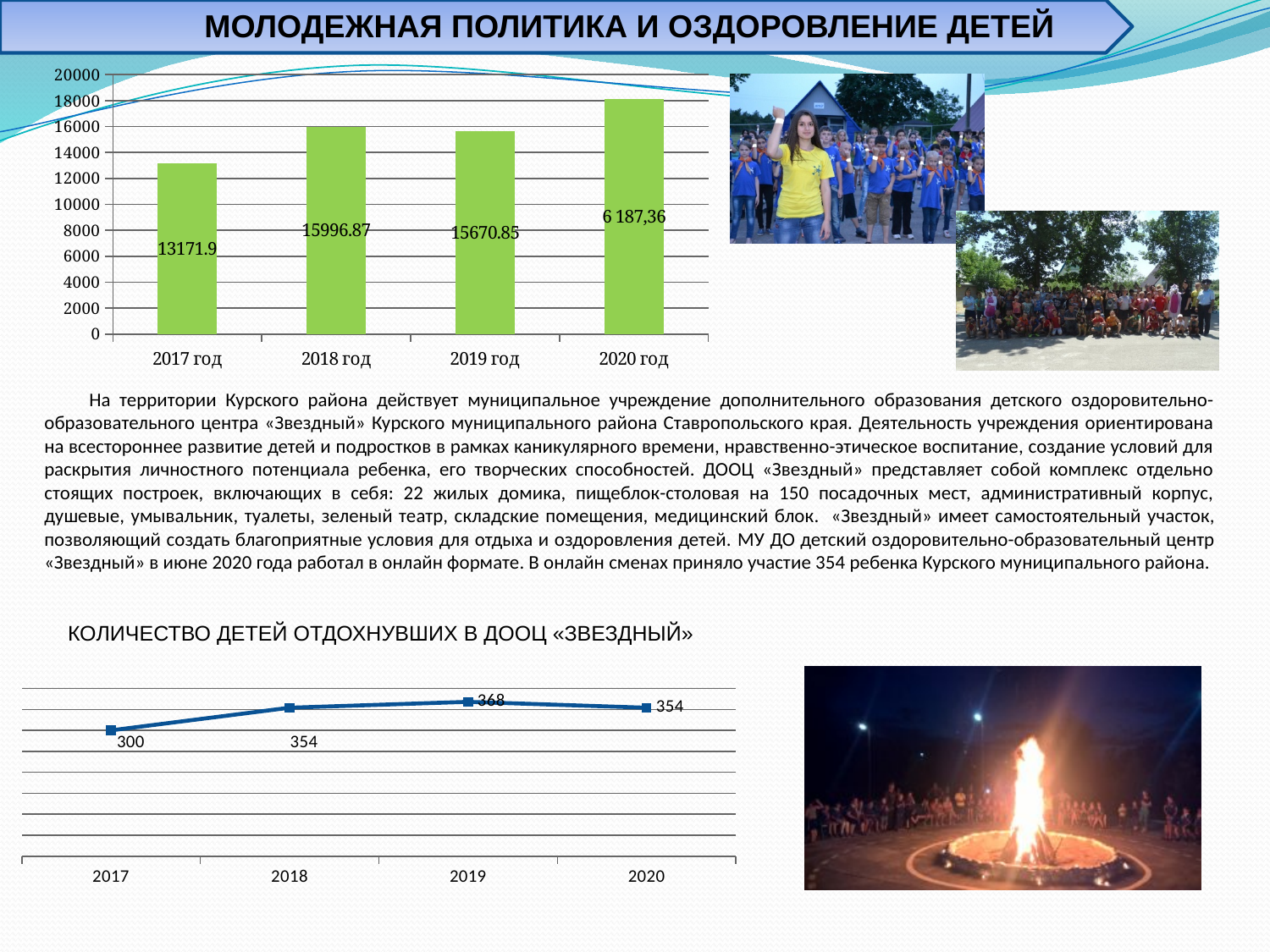
In the chart titled 'КОЛИЧЕСТВО ДЕТЕЙ ОТДОХНУВШИХ В ДООЦ «ЗВЕЗДНЫЙ»', what is the value for 2017? 300 In the chart titled 'КОЛИЧЕСТВО ДЕТЕЙ ОТДОХНУВШИХ В ДООЦ «ЗВЕЗДНЫЙ»', what is the difference between the values for 2019 and 2017? 68 In the chart titled 'КОЛИЧЕСТВО ДЕТЕЙ ОТДОХНУВШИХ В ДООЦ «ЗВЕЗДНЫЙ»', which year has the lowest value? 2017 What kind of chart is the bottom chart titled 'КОЛИЧЕСТВО ДЕТЕЙ ОТДОХНУВШИХ В ДООЦ «ЗВЕЗДНЫЙ»'? line chart In the top bar chart, what is the value for 2019 год? 15670.85 In the top bar chart, what is the value for 2017 год? 13171.9 In the top bar chart, what is the difference between the values for 2018 год and 2019 год? 326.02 In the top bar chart, what is the value for 2018 год? 15996.87 In the top bar chart, which is larger, the value for 2018 год or 2019 год? 2018 год In the top bar chart, is the value for 2017 год greater or less than 14000? less What kind of chart is the top chart on the slide? bar chart In the chart titled 'КОЛИЧЕСТВО ДЕТЕЙ ОТДОХНУВШИХ В ДООЦ «ЗВЕЗДНЫЙ»', which year has the highest value? 2019